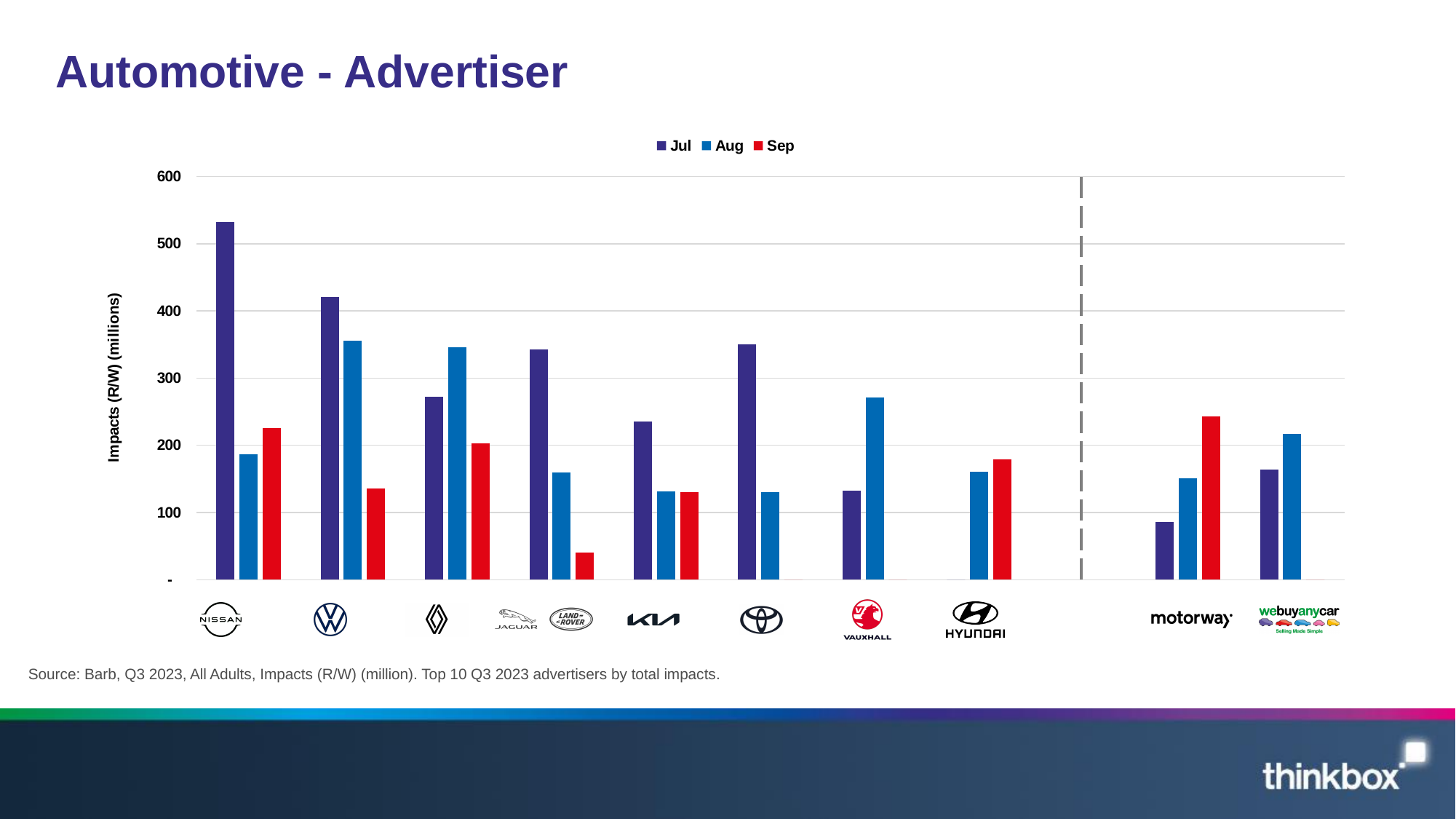
Is the Aug value for Vauxhall greater or less than 200? greater How many series does the legend list? 3 For Vauxhall, which is larger: the Jul value or the Aug value? Aug Is the Sep value for Jaguar Land Rover greater or less than 100? less How many advertisers are shown along the x axis? 10 Do Motorway's values rise or fall from Jul to Sep? rise Which advertiser has the highest Jul value? Nissan What kind of chart is shown on the slide? Bar chart What are the three series named in the legend? Jul, Aug, Sep What is the label on the vertical axis? Impacts (R/W) (millions) Is the Jul value for Motorway greater or less than 100? less